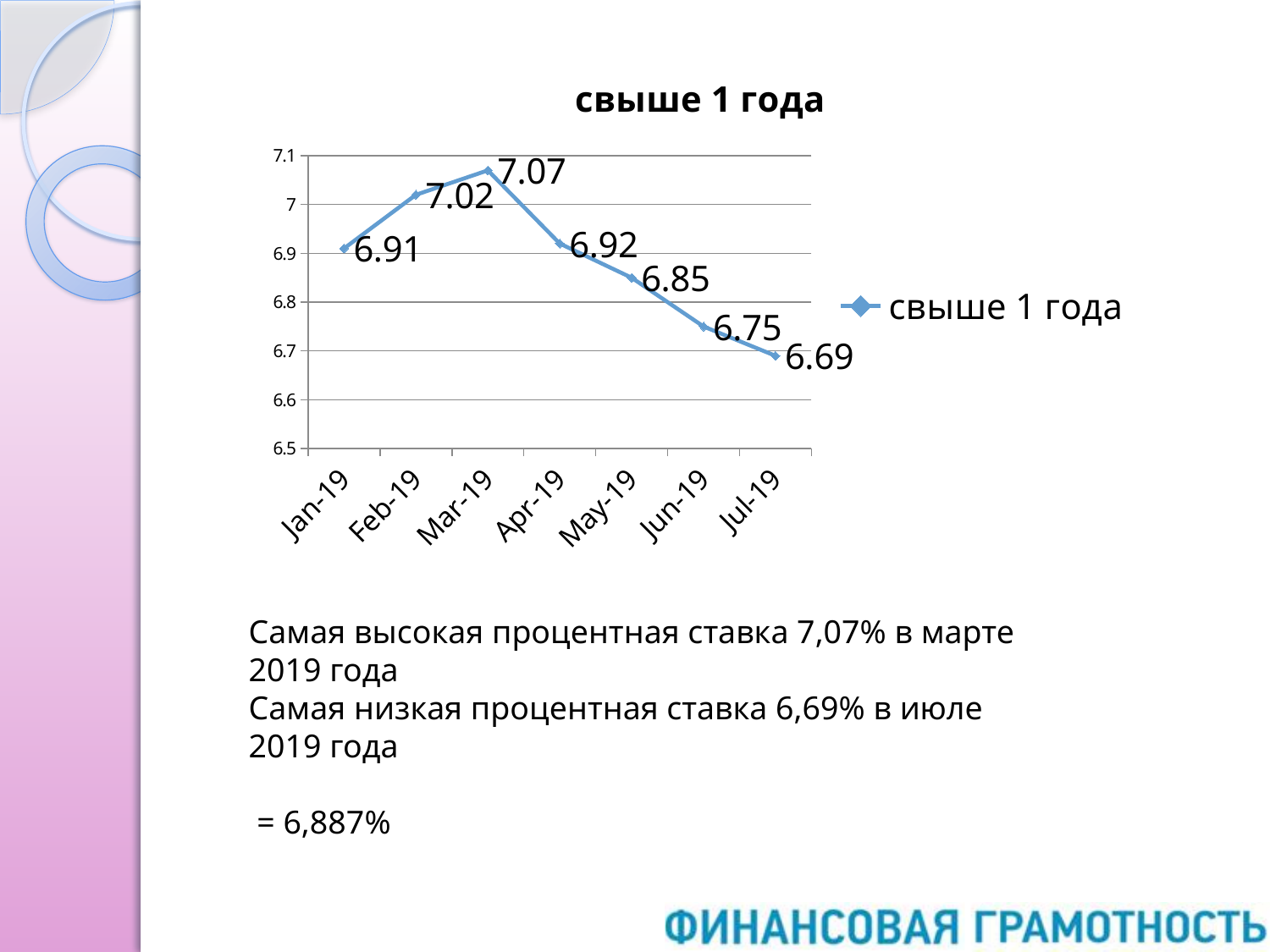
Do the values rise or fall from Mar-19 to Jul-19? fall Which is larger, the value for Feb-19 or the value for Apr-19? Feb-19 How many series does the legend list? 1 Is the value for May-19 greater or less than 6.9? less What is the difference between the values for Mar-19 and Jul-19? 0.38 How many months are plotted on the chart? 7 Which month has the highest value? Mar-19 What is the value for Jan-19? 6.91 Which month has the lowest value? Jul-19 What is the value for Mar-19? 7.07 What kind of chart is shown? line chart What is the value for Jul-19? 6.69